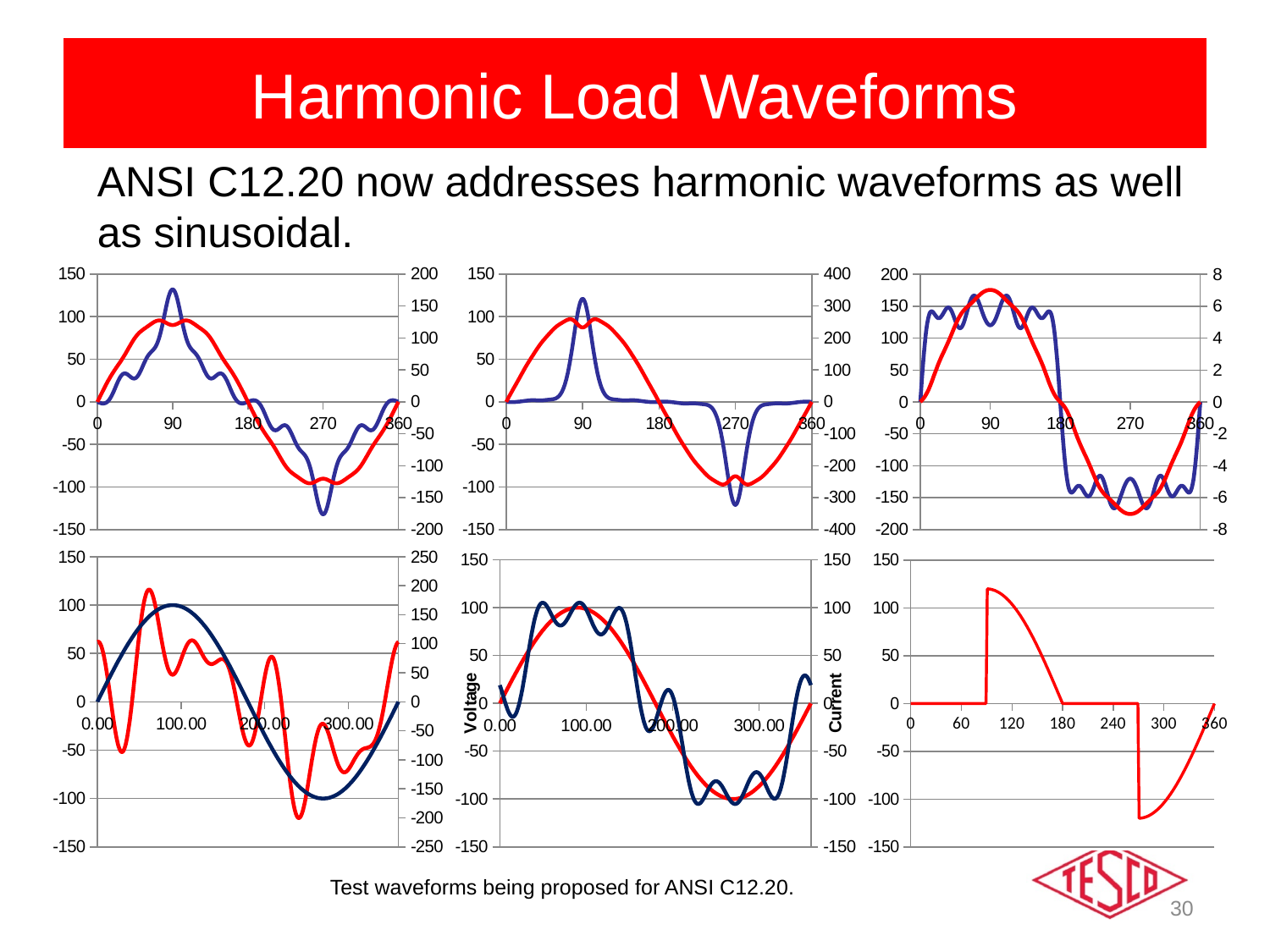
How many lines are plotted in the bottom-right chart? 1 In the bottom-right chart, does the red line rise or fall between x = 270 and x = 360? rise What kind of chart is the bottom-right chart? line chart In the bottom-right chart, does the red line rise or fall between x = 90 and x = 180? fall How many charts are shown on the slide? 6 In the bottom-right chart, is the value of the red line at x = 300 greater or less than -50? less In the bottom-right chart, is the value of the red line at x = 120 greater or less than 50? greater In the bottom-right chart, what is the value of the red line at x = 60? 0 In the bottom-right chart, what is the value of the red line at x = 240? 0 In the bottom-right chart, is the value of the red line at x = 150 greater or less than 100? less What kind of chart is the top-left chart? line chart In the bottom-middle chart, what are the labels on the left and right vertical axes? Voltage and Current